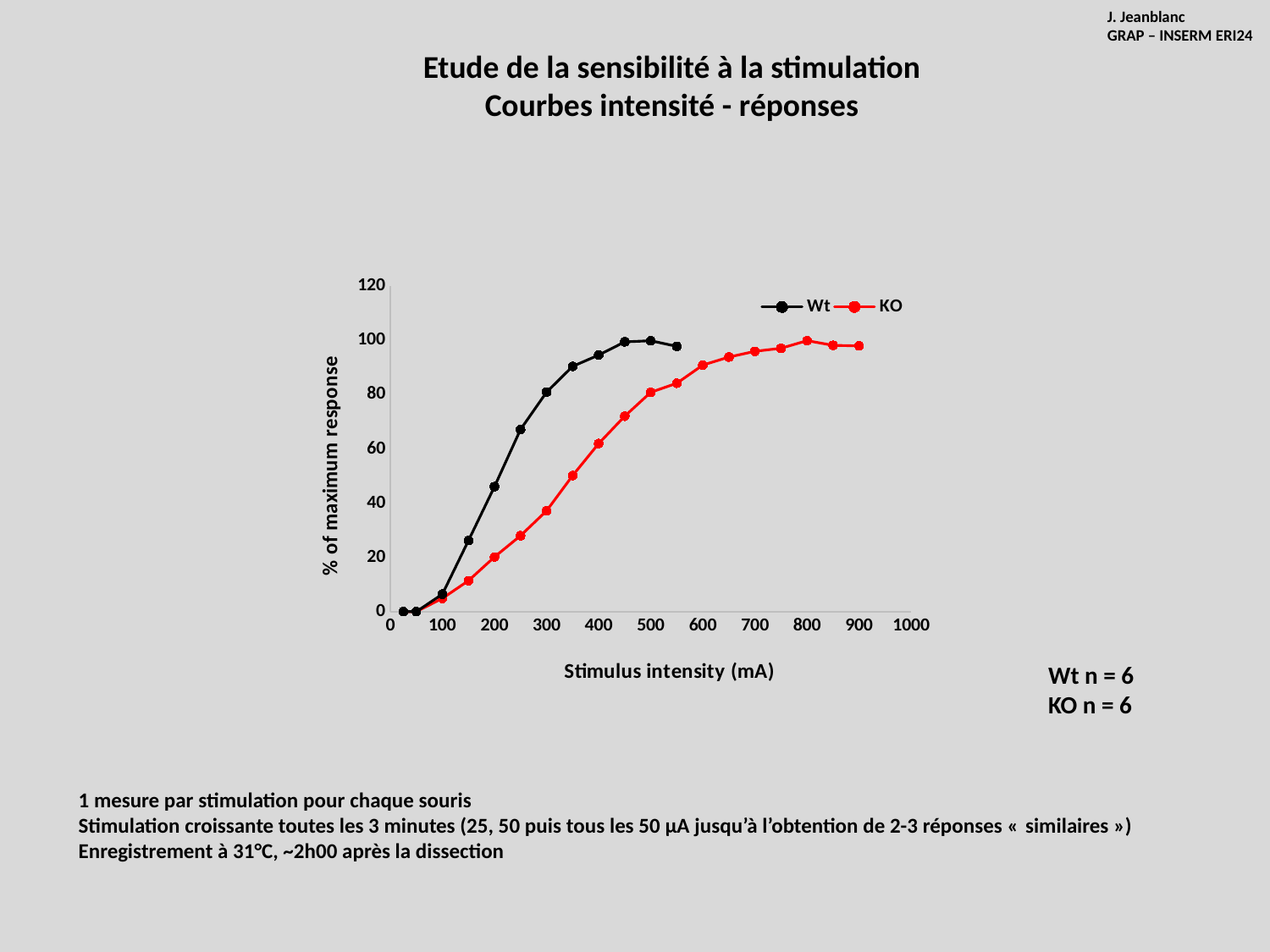
Is the KO value at 600 mA greater or less than 80? greater What is the label of the x axis? Stimulus intensity (mA) Which series is drawn in red? KO Is the Wt value at 200 mA greater or less than 40? greater What kind of chart is shown on the slide? line chart Is the KO value at 300 mA greater or less than 40? less Which series reaches 100% of maximum response at a lower stimulus intensity, Wt or KO? Wt How many series does the legend list? 2 Do the KO values generally rise or fall as stimulus intensity increases from 0 to 800 mA? rise At a stimulus intensity of 300 mA, which series has the higher value, Wt or KO? Wt